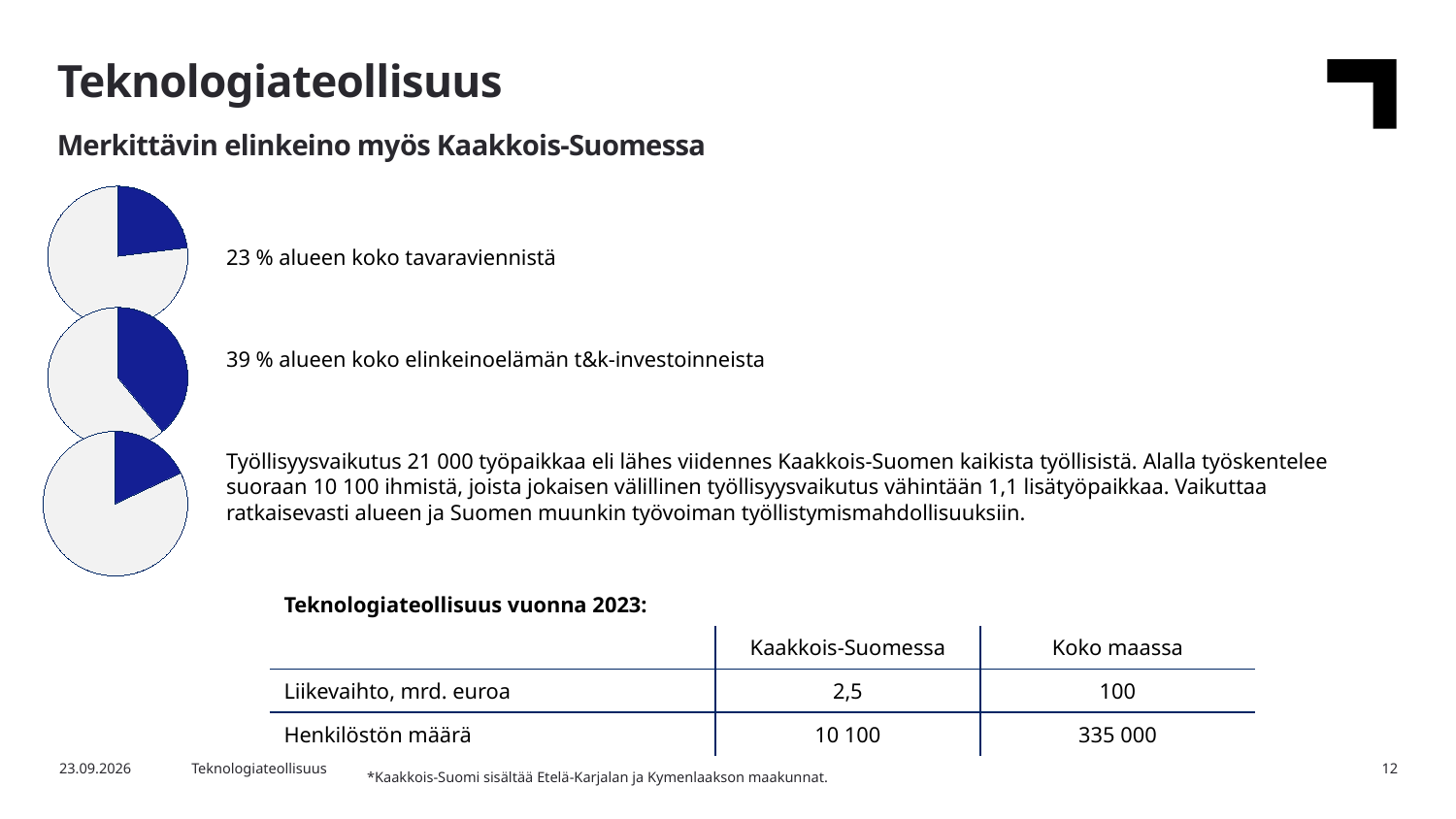
Is the highlighted slice in the middle pie chart greater or less than 25% of the pie? greater According to the text next to the top pie chart, what share of the region's total goods exports does the highlighted slice represent? 23 % What colour is used for the highlighted slice in each pie chart? Dark blue Is the highlighted slice in the bottom pie chart greater or less than 50% of the pie? less How many pie charts are on the slide? 3 Which pie chart has the largest highlighted (dark blue) slice: the top, middle or bottom one? Middle What is the title of the slide containing the pie charts? Teknologiateollisuus What is the difference in percentage points between the shares shown for the middle pie chart (39 %) and the top pie chart (23 %)? 16 percentage points According to the text next to the middle pie chart, what share of the region's business R&D investments does the highlighted slice represent? 39 % Is the highlighted slice in the top pie chart larger or smaller than the highlighted slice in the middle pie chart? Smaller What kind of charts are shown on the left side of the slide? Pie charts